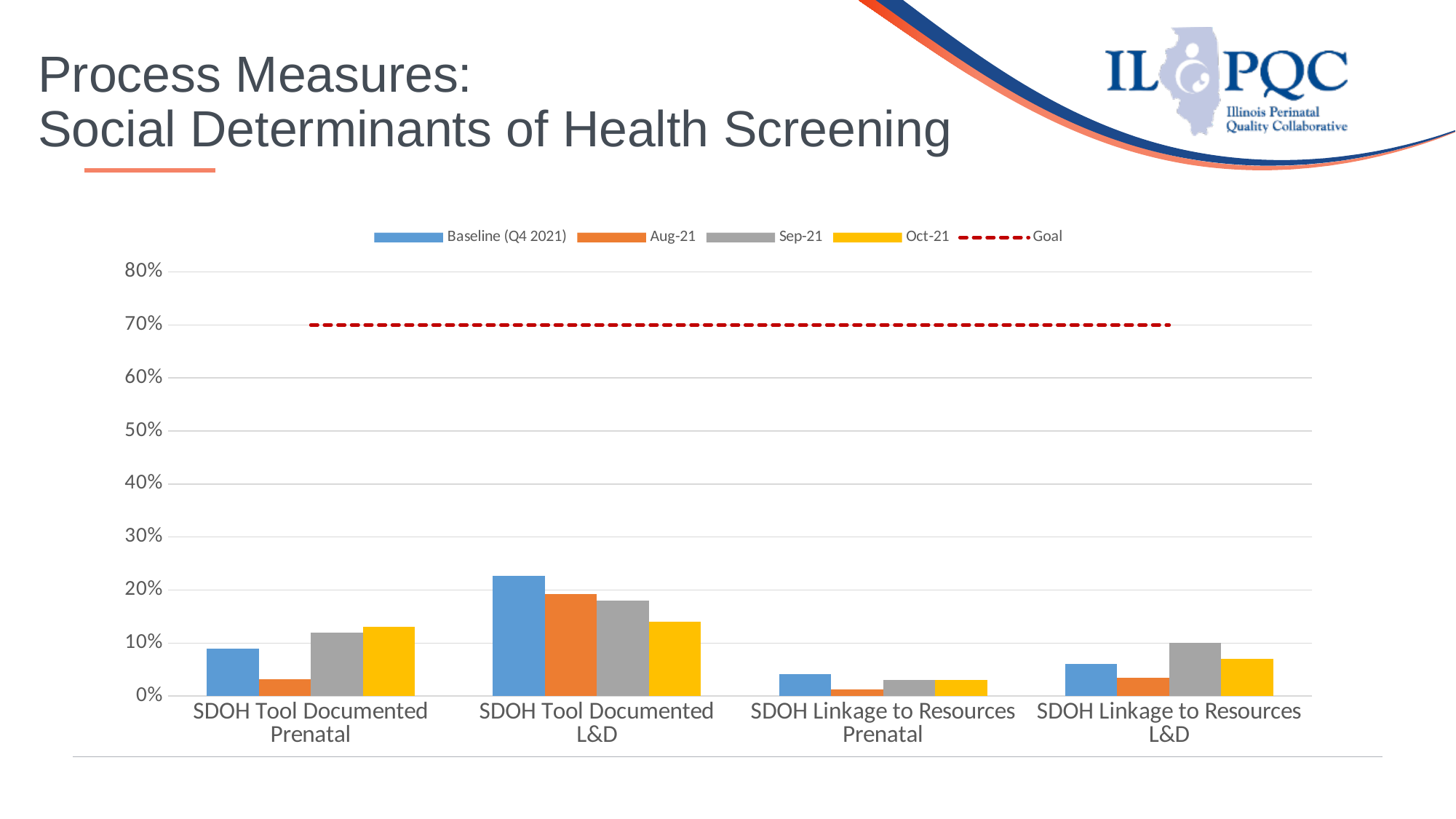
Which category has the lowest Aug-21 bar? SDOH Linkage to Resources Prenatal For SDOH Tool Documented L&D, do the bars rise or fall from Baseline (Q4 2021) through Oct-21? fall Which category has the highest Baseline (Q4 2021) bar? SDOH Tool Documented L&D Is the Aug-21 value for SDOH Linkage to Resources Prenatal greater or less than 10%? less How many series does the legend list? 5 What kind of chart is shown on the slide? bar chart Is the Baseline (Q4 2021) value for SDOH Tool Documented L&D greater or less than 20%? greater What colour are the Oct-21 bars? yellow How many categories are shown on the x axis? 4 For SDOH Tool Documented L&D, which is larger: the Baseline (Q4 2021) value or the Oct-21 value? Baseline (Q4 2021) Is the Oct-21 value for SDOH Tool Documented Prenatal greater or less than 10%? greater What value does the Goal line sit at? 70%